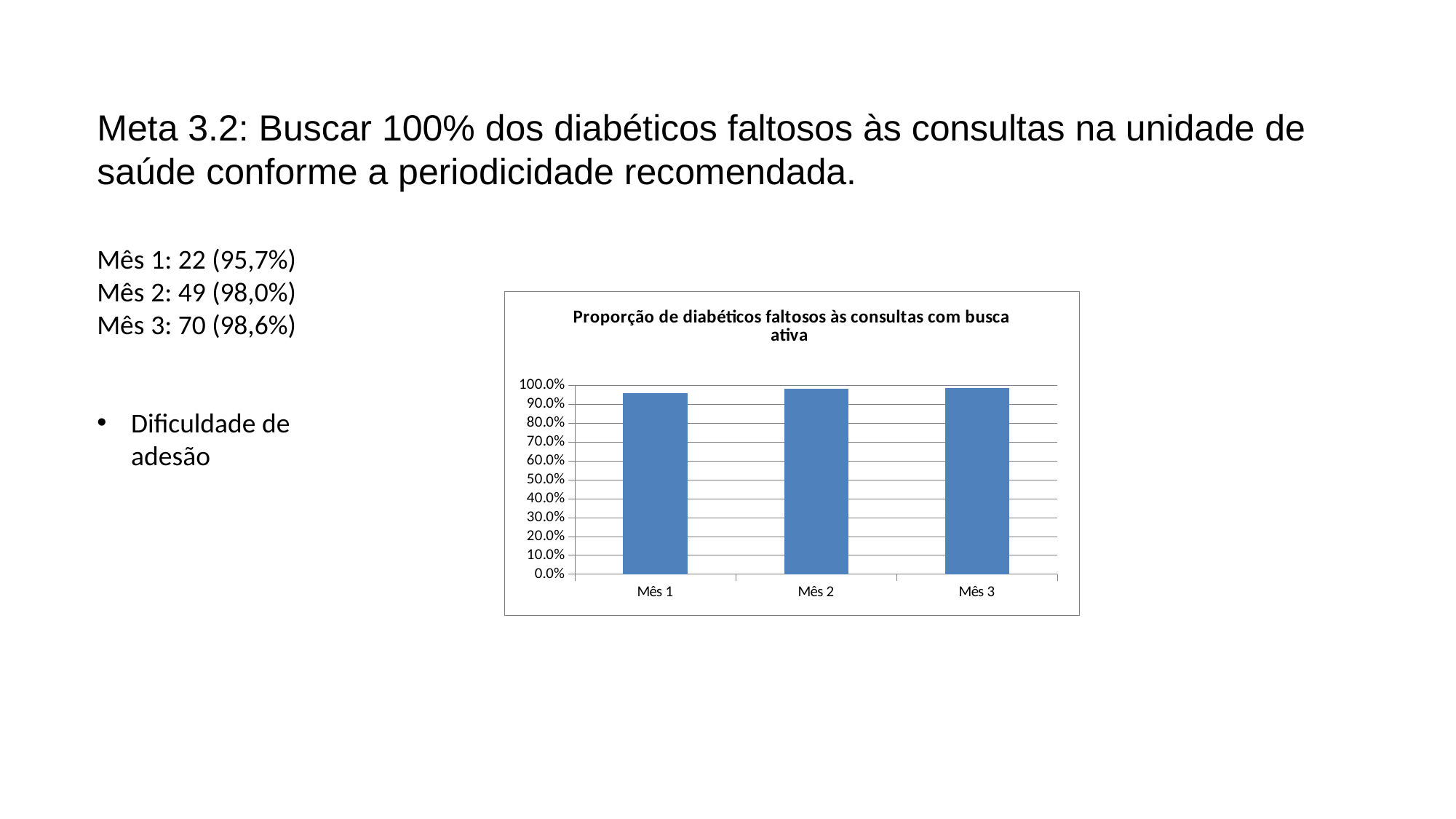
According to the slide text, what is the proportion for Mês 3? 98,6% According to the slide text, what is the proportion for Mês 1? 95,7% Which is larger, the value for Mês 1 or the value for Mês 3? Mês 3 Is the value for Mês 2 greater or less than 100.0%? less What kind of chart is shown on the slide? bar chart How many categories (months) are plotted on the x axis of the chart? 3 Do the values rise or fall from Mês 1 to Mês 3? rise Which month has the lowest proportion in the chart? Mês 1 Is the value for Mês 1 greater or less than 90.0%? greater What is the highest value shown on the y axis of the chart? 100.0% Is the value for Mês 3 greater or less than 90.0%? greater What is the title of the chart? Proporção de diabéticos faltosos às consultas com busca ativa